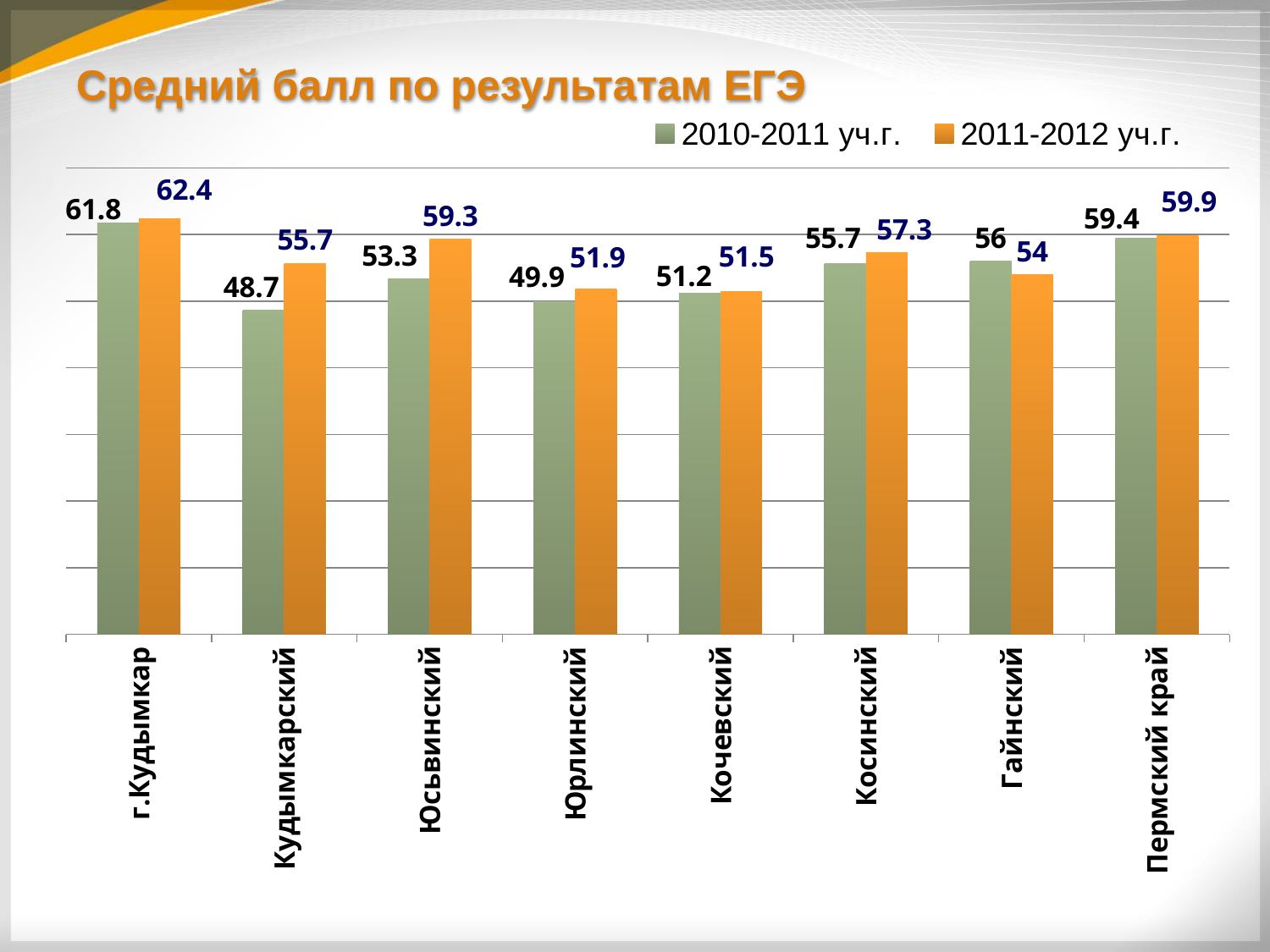
What is the value for Кудымкарский in the 2010-2011 уч.г. series? 48.7 Which category has the lowest value in the 2010-2011 уч.г. series? Кудымкарский What is the value for Гайнский in the 2011-2012 уч.г. series? 54 What is the difference between the 2010-2011 уч.г. and 2011-2012 уч.г. values for Гайнский? 2 What is the title of the chart? Средний балл по результатам ЕГЭ Which category has the highest value in the 2011-2012 уч.г. series? г.Кудымкар What kind of chart is shown on the slide? Bar chart How many series does the legend list? 2 What is the difference between the 2011-2012 уч.г. and 2010-2011 уч.г. values for Кудымкарский? 7 What is the value for Юсьвинский in the 2011-2012 уч.г. series? 59.3 How many categories are shown on the x axis? 8 For Гайнский, which series has the larger value: 2010-2011 уч.г. or 2011-2012 уч.г.? 2010-2011 уч.г.